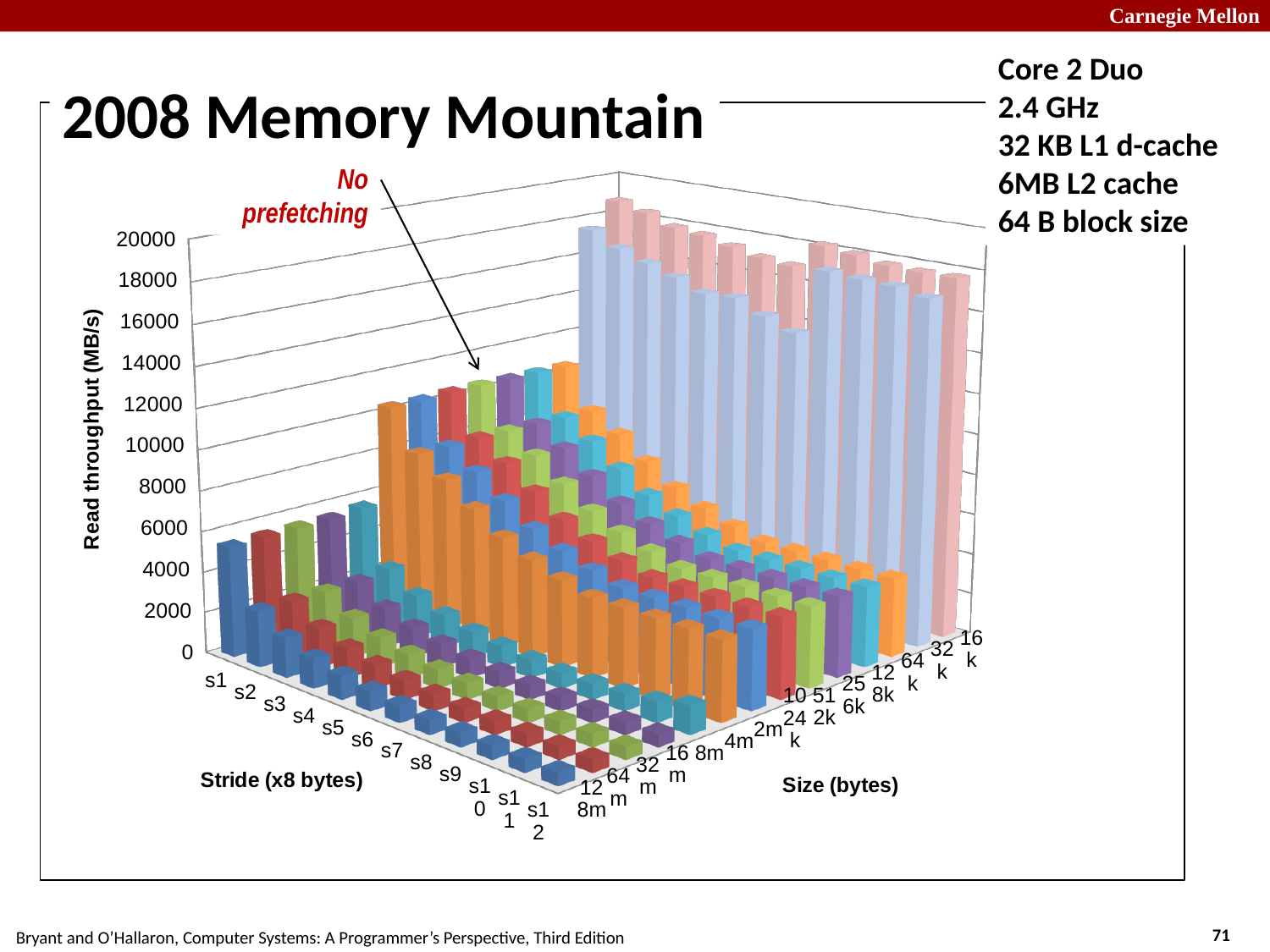
What kind of chart is shown on the slide? 3D bar chart Is the read throughput for stride s1 at the largest size (front-left bar) greater or less than 2000? greater What is the label of the vertical axis of the chart? Read throughput (MB/s) How many stride categories (s1 through s12) are shown on the stride axis? 12 Is the read throughput for stride s1 at the largest size (front-left bar) greater or less than 10000? less What is the maximum value shown on the Read throughput axis? 20000 Which stride has the higher read throughput at the largest size (front row): s1 or s12? s1 Are the tallest bars in the chart found at the smallest sizes (16k/32k) or at the largest sizes (128m/64m)? smallest sizes (16k/32k) What is the title of the chart? 2008 Memory Mountain For the largest size (front row), does read throughput rise or fall as the stride increases from s1 to s12? fall